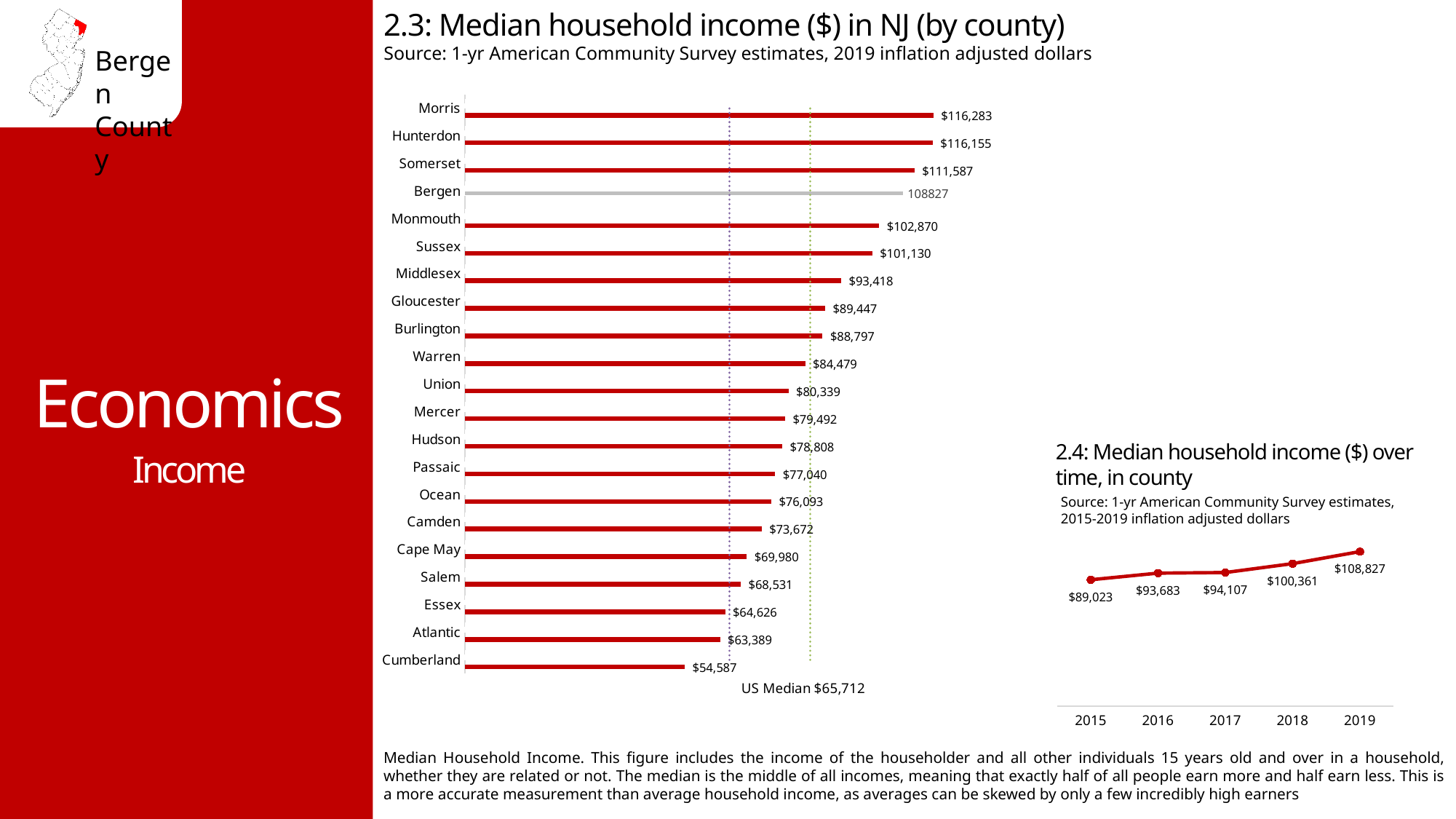
In the chart '2.3: Median household income ($) in NJ (by county)', how many counties are listed? 21 In the chart '2.3: Median household income ($) in NJ (by county)', what value is shown for Bergen? 108827 In the chart '2.3: Median household income ($) in NJ (by county)', which county has the lowest median household income? Cumberland In the chart '2.3: Median household income ($) in NJ (by county)', what US Median value is noted? $65,712 What kind of chart is '2.3: Median household income ($) in NJ (by county)'? Bar chart In the chart '2.4: Median household income ($) over time, in county', does the median household income rise or fall from 2015 to 2019? Rise In the chart '2.3: Median household income ($) in NJ (by county)', which has a higher median household income, Hudson or Passaic? Hudson In the chart '2.3: Median household income ($) in NJ (by county)', what is the median household income for Somerset? $111,587 In the chart '2.3: Median household income ($) in NJ (by county)', which county has the highest median household income? Morris In the chart '2.4: Median household income ($) over time, in county', what is the difference between the 2019 and 2015 values? $19,804 In the chart '2.4: Median household income ($) over time, in county', what is the value for 2017? $94,107 In the chart '2.3: Median household income ($) in NJ (by county)', what is the difference between the values for Morris and Hunterdon? $128